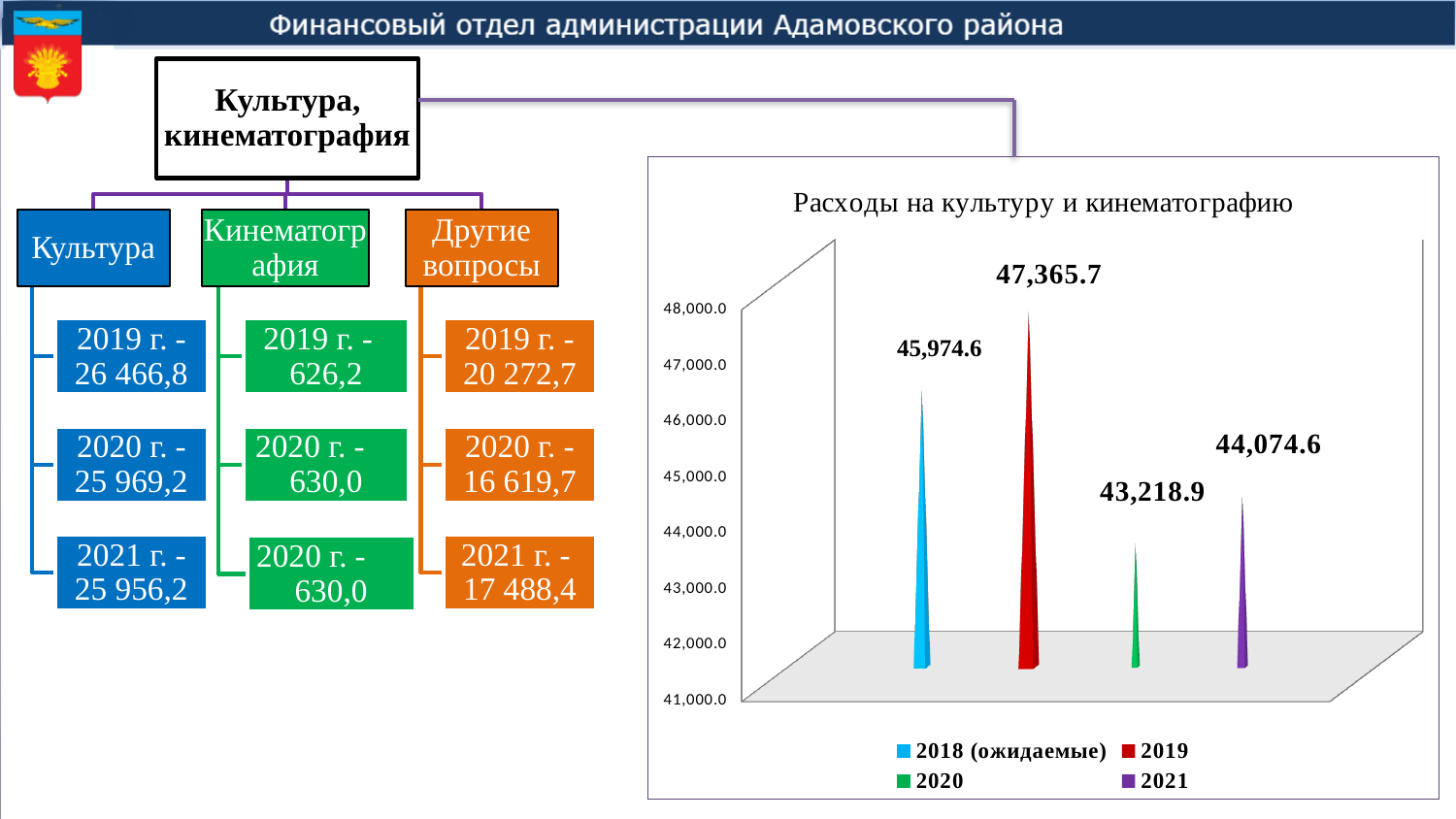
Which year has the lowest value in the chart? 2020 What kind of chart is shown on the slide? bar chart What is the value for 2019 in the chart? 47,365.7 What is the difference between the values for 2019 and 2018 (ожидаемые)? 1,391.1 What is the title of the chart on the slide? Расходы на культуру и кинематографию Which year has the highest value in the chart? 2019 What is the value for 2018 (ожидаемые) in the chart? 45,974.6 How many series does the chart legend list? 4 What is the difference between the values for 2021 and 2020? 855.7 Which is larger, the value for 2021 or the value for 2020? 2021 What is the value for 2021 in the chart? 44,074.6 What is the value for 2020 in the chart? 43,218.9